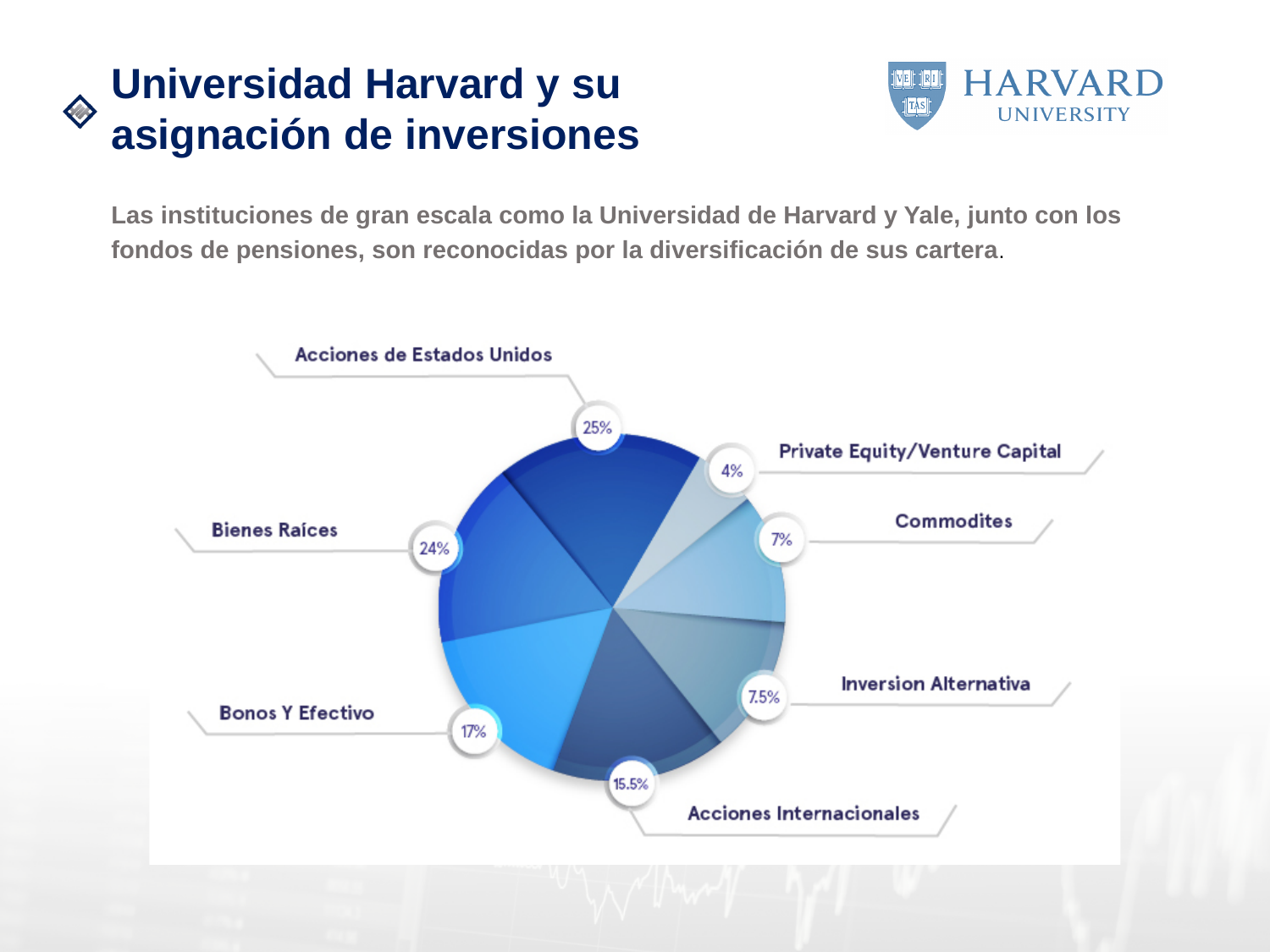
Which is larger, the share for Inversion Alternativa or the share for Commodites? Inversion Alternativa What is the difference between the shares of Bonos Y Efectivo and Commodites? 10% What type of chart is shown on the slide? Pie chart What percentage of the portfolio is allocated to Acciones de Estados Unidos? 25% What percentage is shown for Private Equity/Venture Capital? 4% What is the combined share of Acciones de Estados Unidos and Bienes Raíces? 49% Which category has the largest share of the pie chart? Acciones de Estados Unidos What is the value shown for Acciones Internacionales? 15.5% How many categories are shown in the pie chart? 7 What is the value for Inversion Alternativa? 7.5% What share does Bienes Raíces have in the pie chart? 24% Which category has the smallest share of the pie chart? Private Equity/Venture Capital